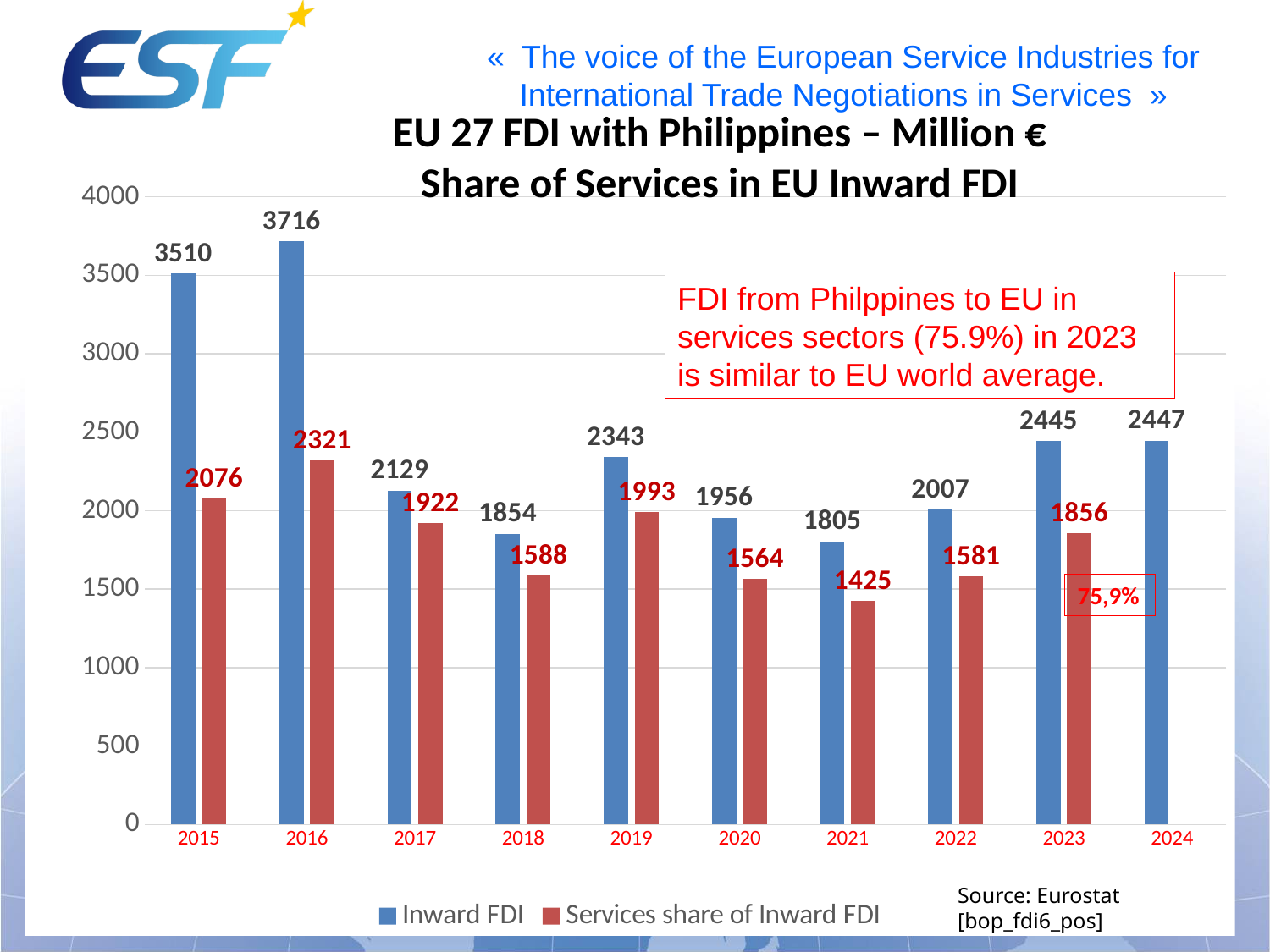
Which year has the highest Inward FDI? 2016 What is the difference between Inward FDI and Services share of Inward FDI in 2023? 589 What is the Services share of Inward FDI value for 2021? 1425 Is the Inward FDI value for 2021 greater or less than 2000? less What kind of chart is shown on the slide? bar chart Which year has the lowest Services share of Inward FDI? 2021 What is the Inward FDI value for 2016? 3716 Which is larger: Inward FDI in 2019 or Inward FDI in 2017? 2019 How many series does the legend list? 2 Does Inward FDI rise or fall from 2015 to 2018? fall What is the difference between Inward FDI in 2016 and Inward FDI in 2015? 206 How many years are shown on the x axis? 10